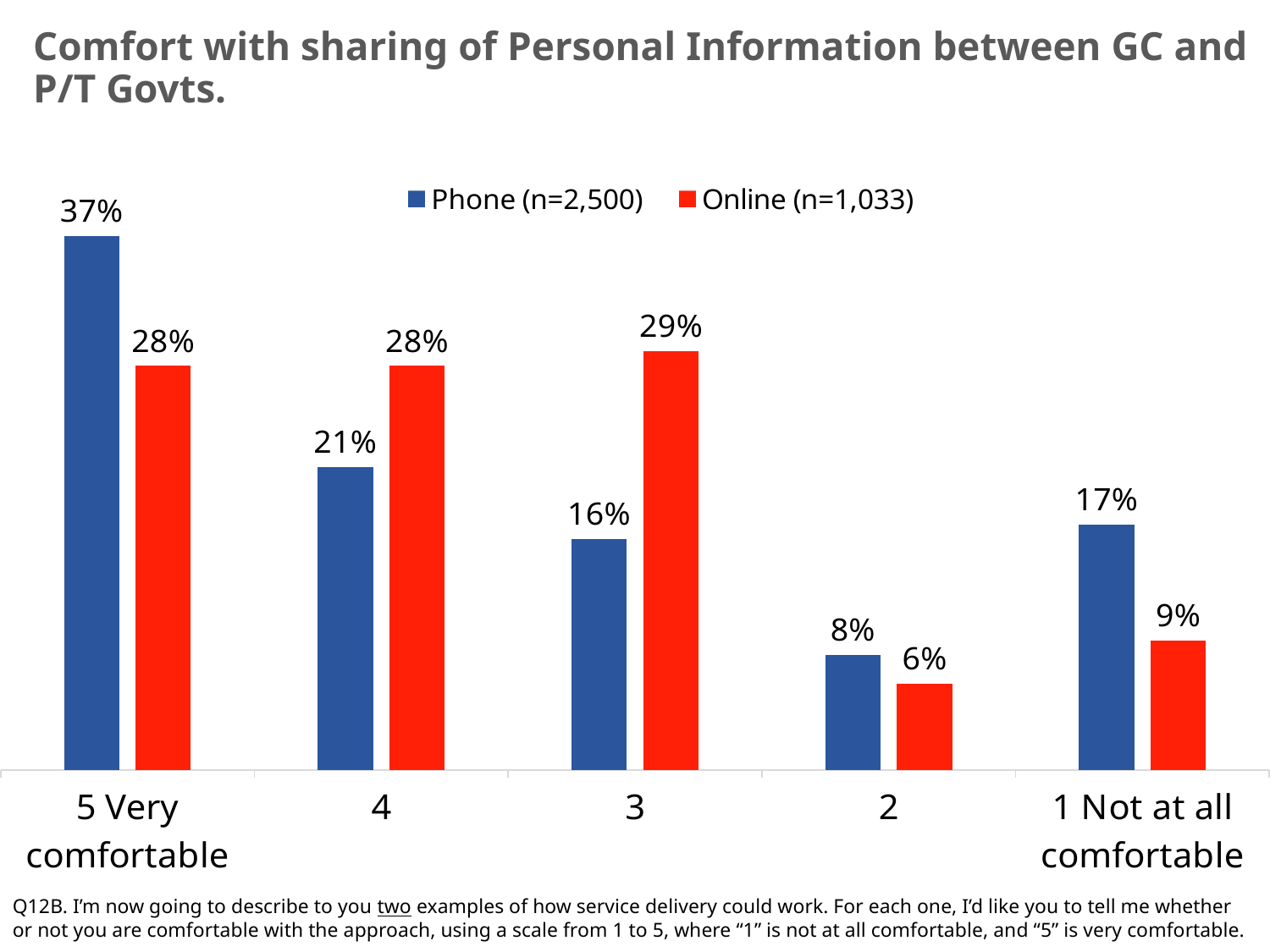
What is the Phone value for "1 Not at all comfortable"? 17% What sample size is shown in the legend for the Online series? n=1,033 Which category has the lowest Online value? 2 What is the difference between the Phone and Online values for "5 Very comfortable"? 9% What is the Online value for "3"? 29% How many categories are shown on the x axis? 5 What is the Phone value for "5 Very comfortable"? 37% How many series does the legend list? 2 For category "4", which series has the larger value, Phone or Online? Online What is the difference between the Online values for "3" and "2"? 23% What kind of chart is shown on the slide? Bar chart Which category has the highest Phone value? 5 Very comfortable